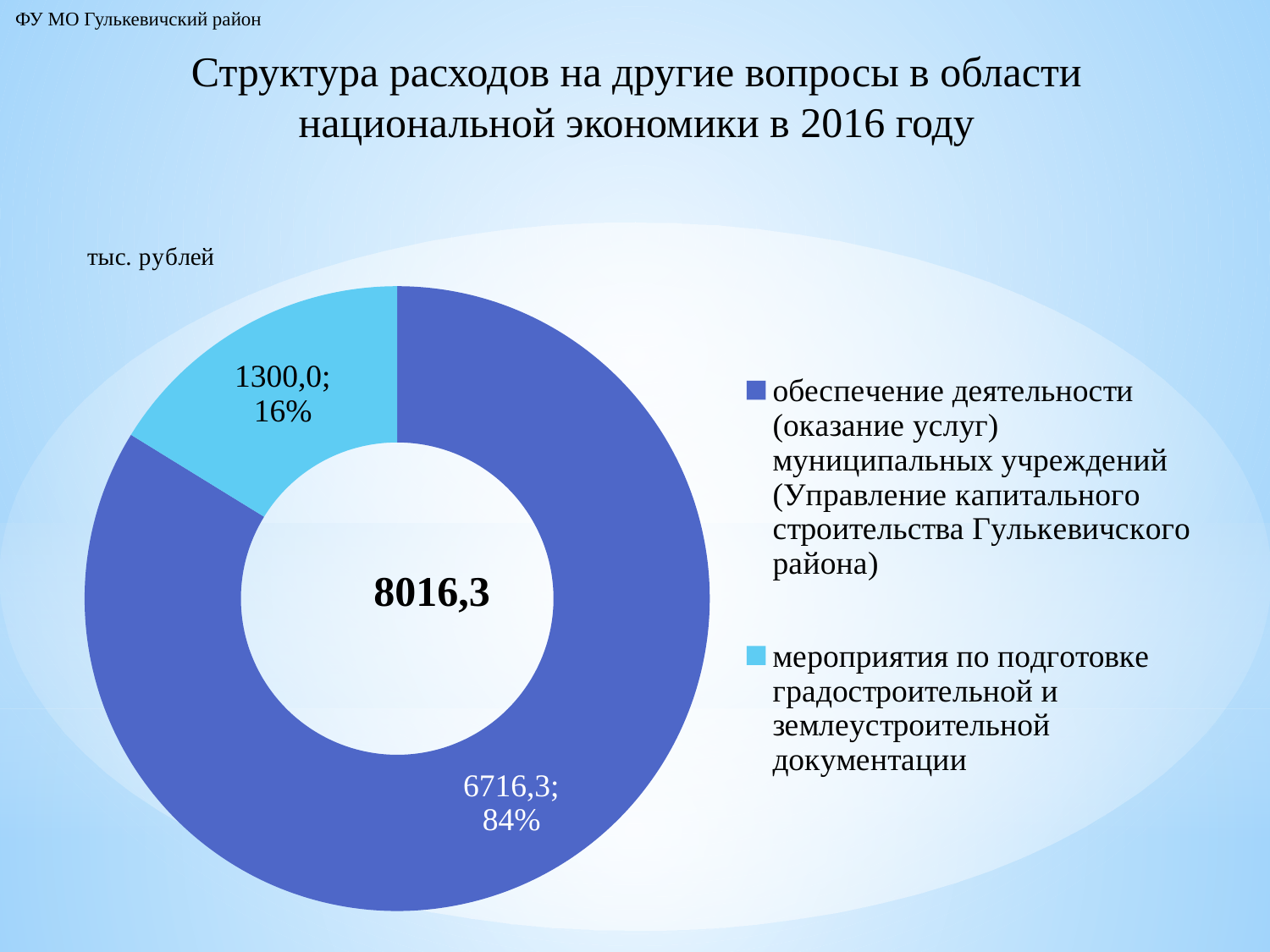
What is the difference between the value for 'обеспечение деятельности' and the value for 'мероприятия по подготовке градостроительной и землеустроительной документации'? 5416,3 Which category has the largest value? обеспечение деятельности (оказание услуг) муниципальных учреждений (Управление капитального строительства Гулькевичского района) What total is shown in the centre of the chart? 8016,3 What share of the chart does 'обеспечение деятельности (оказание услуг) муниципальных учреждений' represent? 84% Which is larger: the value for 'обеспечение деятельности' or the value for 'мероприятия по подготовке градостроительной и землеустроительной документации'? обеспечение деятельности What is the value for 'обеспечение деятельности (оказание услуг) муниципальных учреждений (Управление капитального строительства Гулькевичского района)'? 6716,3 What kind of chart is shown on the slide? doughnut chart How many categories does the chart show? 2 What is the value for 'мероприятия по подготовке градостроительной и землеустроительной документации'? 1300,0 What share of the chart does 'мероприятия по подготовке градостроительной и землеустроительной документации' represent? 16% In what units are the chart values given? тыс. рублей Which category has the smallest value? мероприятия по подготовке градостроительной и землеустроительной документации